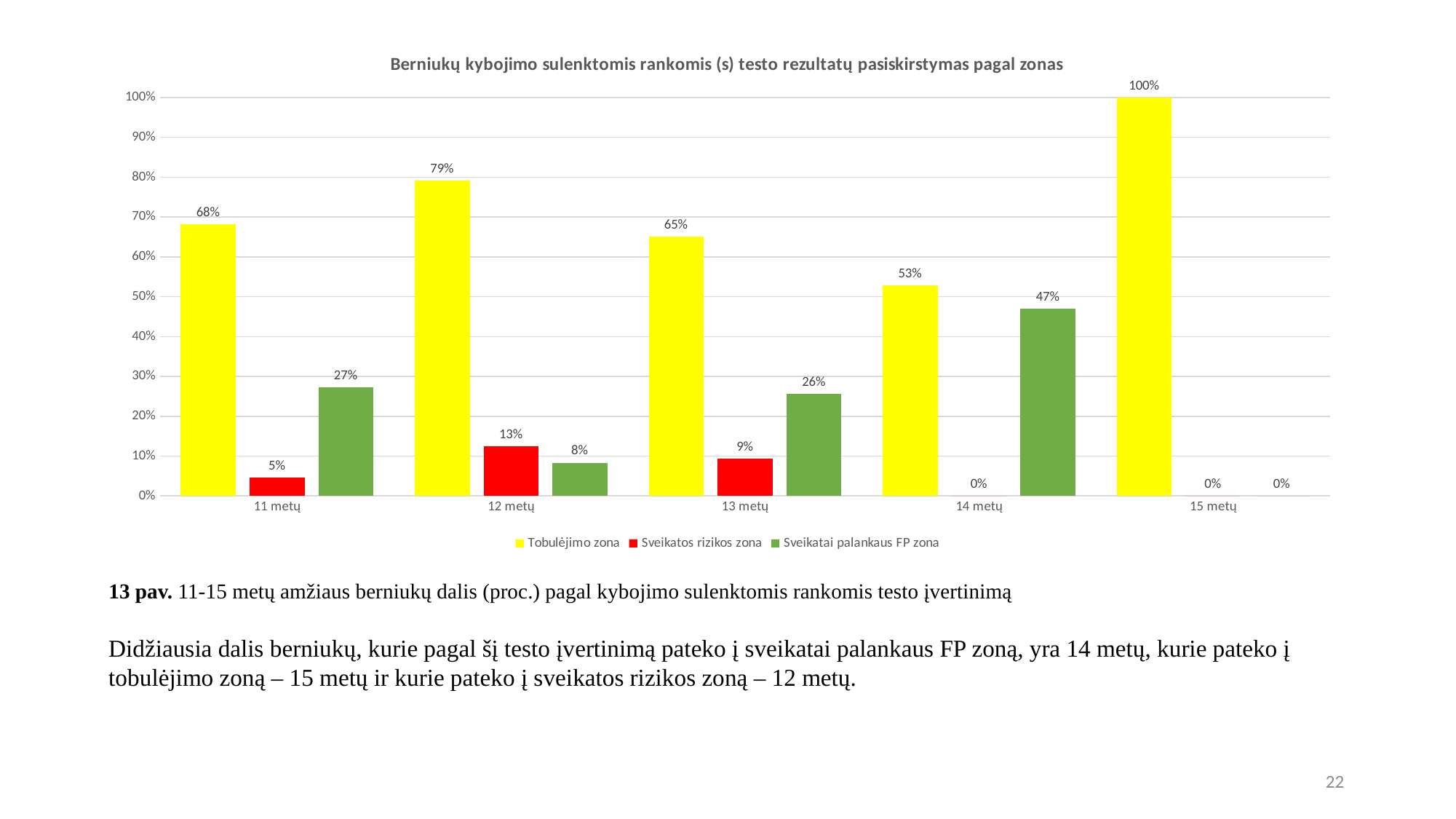
How many series does the legend list? 3 Which age group has the highest value for Tobulėjimo zona? 15 metų What is the value for Tobulėjimo zona at 12 metų? 79% Which age group has the lowest value for Sveikatai palankaus FP zona? 15 metų What is the difference between the Tobulėjimo zona values for 11 metų and 14 metų? 15% Is the value for Tobulėjimo zona at 13 metų greater or less than 60%? greater What kind of chart is shown on the slide? Bar chart Which is larger: Sveikatai palankaus FP zona at 11 metų or at 13 metų? 11 metų How many age groups are shown on the x axis? 5 What is the value for Sveikatai palankaus FP zona at 14 metų? 47% Which colour represents Sveikatos rizikos zona in the chart? Red What is the value for Sveikatos rizikos zona at 13 metų? 9%